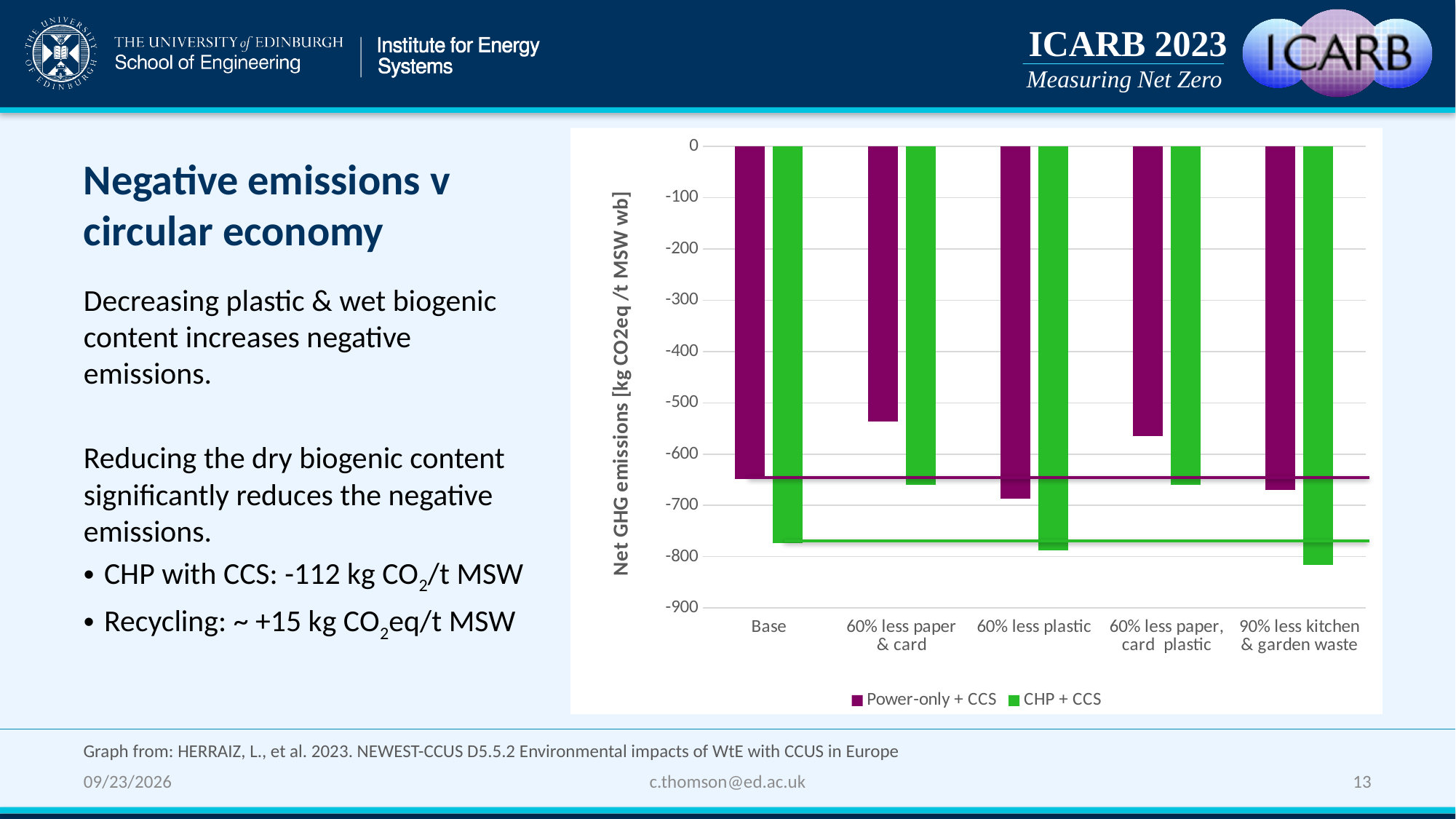
What kind of chart is shown on the slide? bar chart Is the Power-only + CCS value for 60% less paper & card greater or less than -600? greater Which series is shown in green in the chart? CHP + CCS Is the CHP + CCS value for 90% less kitchen & garden waste greater or less than -800? less What is the label of the y axis of the chart? Net GHG emissions [kg CO2eq /t MSW wb] For the Power-only + CCS series, which is lower (more negative): Base or 60% less paper & card? Base How many categories are shown on the x axis of the chart? 5 How many series does the chart legend list? 2 Is the CHP + CCS value for 60% less paper & card greater or less than -700? greater Which category has the highest (least negative) value for the Power-only + CCS series? 60% less paper & card For the Base category, which series has the lower (more negative) value: Power-only + CCS or CHP + CCS? CHP + CCS